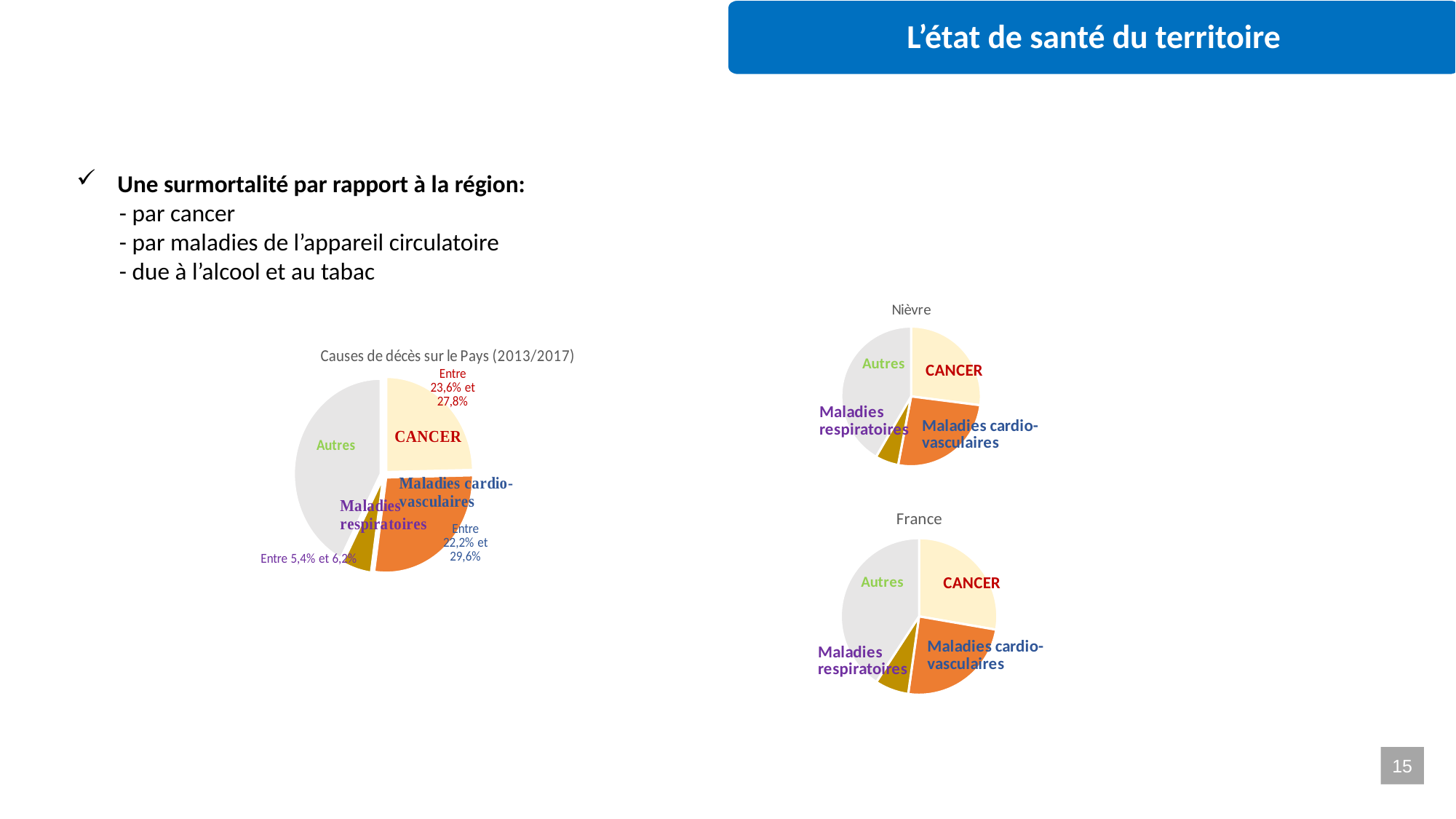
In the 'Causes de décès sur le Pays (2013/2017)' chart, what range is printed next to the Maladies respiratoires slice? Entre 5,4% et 6,2% In the 'France' pie chart, which slice is the smallest? Maladies respiratoires How many pie charts are shown on the slide? 3 How many slices does the 'Causes de décès sur le Pays (2013/2017)' pie chart have? 4 In the 'France' pie chart, which slice is larger: Autres or Maladies respiratoires? Autres What kind of chart is the 'Causes de décès sur le Pays (2013/2017)' chart? pie chart In the 'Nièvre' pie chart, which slice is the smallest? Maladies respiratoires In the 'Causes de décès sur le Pays (2013/2017)' chart, what range is printed next to the Maladies cardio-vasculaires slice? Entre 22,2% et 29,6% In the 'Causes de décès sur le Pays (2013/2017)' chart, which slice is the smallest? Maladies respiratoires In the 'Causes de décès sur le Pays (2013/2017)' chart, which slice is the largest? Autres In the 'Causes de décès sur le Pays (2013/2017)' chart, what range is printed next to the CANCER slice? Entre 23,6% et 27,8% What is the title of the pie chart on the left of the slide? Causes de décès sur le Pays (2013/2017)